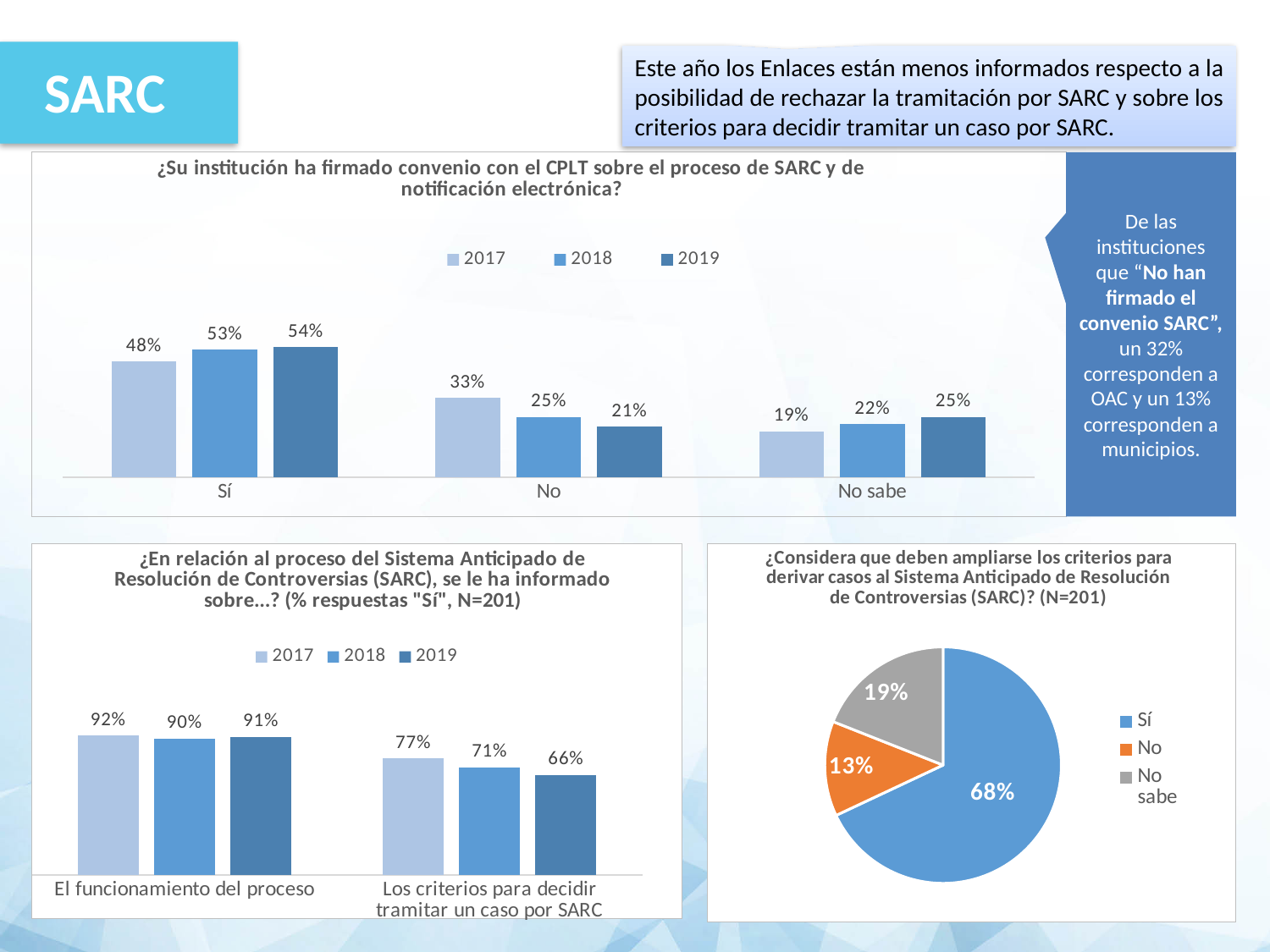
In the bottom-left chart about being informed on the SARC process, what is the difference between the 2017 and 2019 values for 'Los criterios para decidir tramitar un caso por SARC'? 11% In the bottom-left chart about being informed on the SARC process, which is larger: 'El funcionamiento del proceso' in 2017 or in 2018? 2017 In the top chart about whether the institution has signed an agreement with the CPLT, what is the value for 'No' in 2017? 33% What kind of chart is the bottom-right chart about expanding the criteria for referring cases to SARC? pie chart In the top chart about whether the institution has signed an agreement with the CPLT, what is the difference between the 2017 and 2019 values for 'No'? 12% In the bottom-left chart about being informed on the SARC process, what is the value for 'Los criterios para decidir tramitar un caso por SARC' in 2019? 66% In the bottom-right chart about expanding the criteria for referring cases to SARC, what share of responses is 'Sí'? 68% In the top chart about whether the institution has signed an agreement with the CPLT, how many series does the legend list? 3 In the top chart about whether the institution has signed an agreement with the CPLT, what is the value for 'Sí' in 2019? 54% In the top chart about whether the institution has signed an agreement with the CPLT, which response category has the highest value in 2018? Sí In the bottom-left chart about being informed on the SARC process, how many categories are shown on the x axis? 2 In the top chart about whether the institution has signed an agreement with the CPLT, do the values for 'No sabe' rise or fall from 2017 to 2019? rise